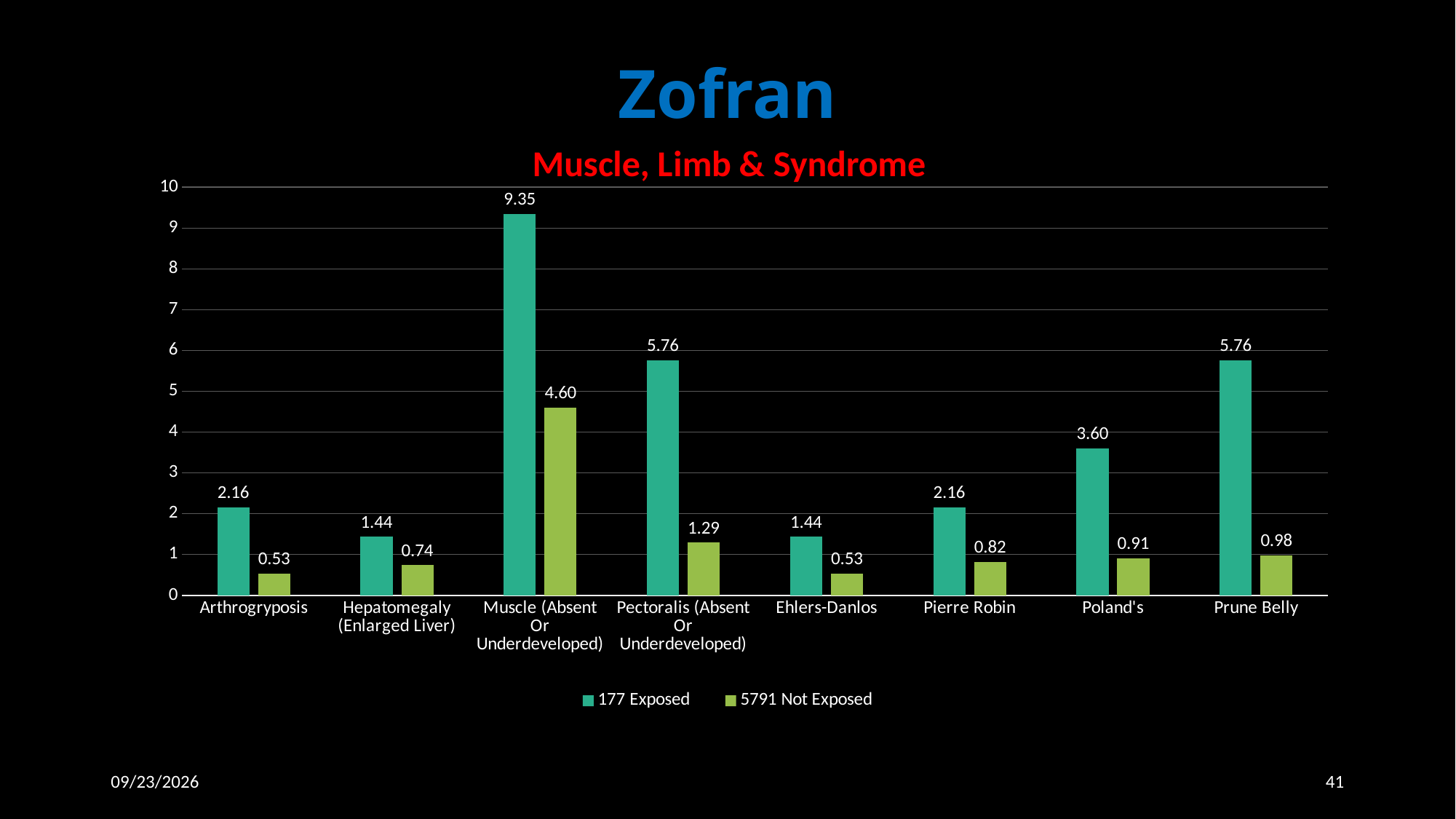
How many series does the legend list? 2 What is the value for 177 Exposed for Muscle (Absent Or Underdeveloped)? 9.35 What is the value for 5791 Not Exposed for Pectoralis (Absent Or Underdeveloped)? 1.29 What is the red subtitle of the chart? Muscle, Limb & Syndrome What is the difference between the 177 Exposed and 5791 Not Exposed values for Muscle (Absent Or Underdeveloped)? 4.75 How many categories are shown on the x axis? 8 Which is larger: the 177 Exposed value for Pierre Robin or the 177 Exposed value for Poland's? Poland's Which category has the highest value for 177 Exposed? Muscle (Absent Or Underdeveloped) What kind of chart is shown on the slide? Bar chart What is the value for 177 Exposed for Poland's? 3.60 Which category has the lowest value for 5791 Not Exposed? Arthrogryposis and Ehlers-Danlos (both 0.53) What is the value for 5791 Not Exposed for Prune Belly? 0.98